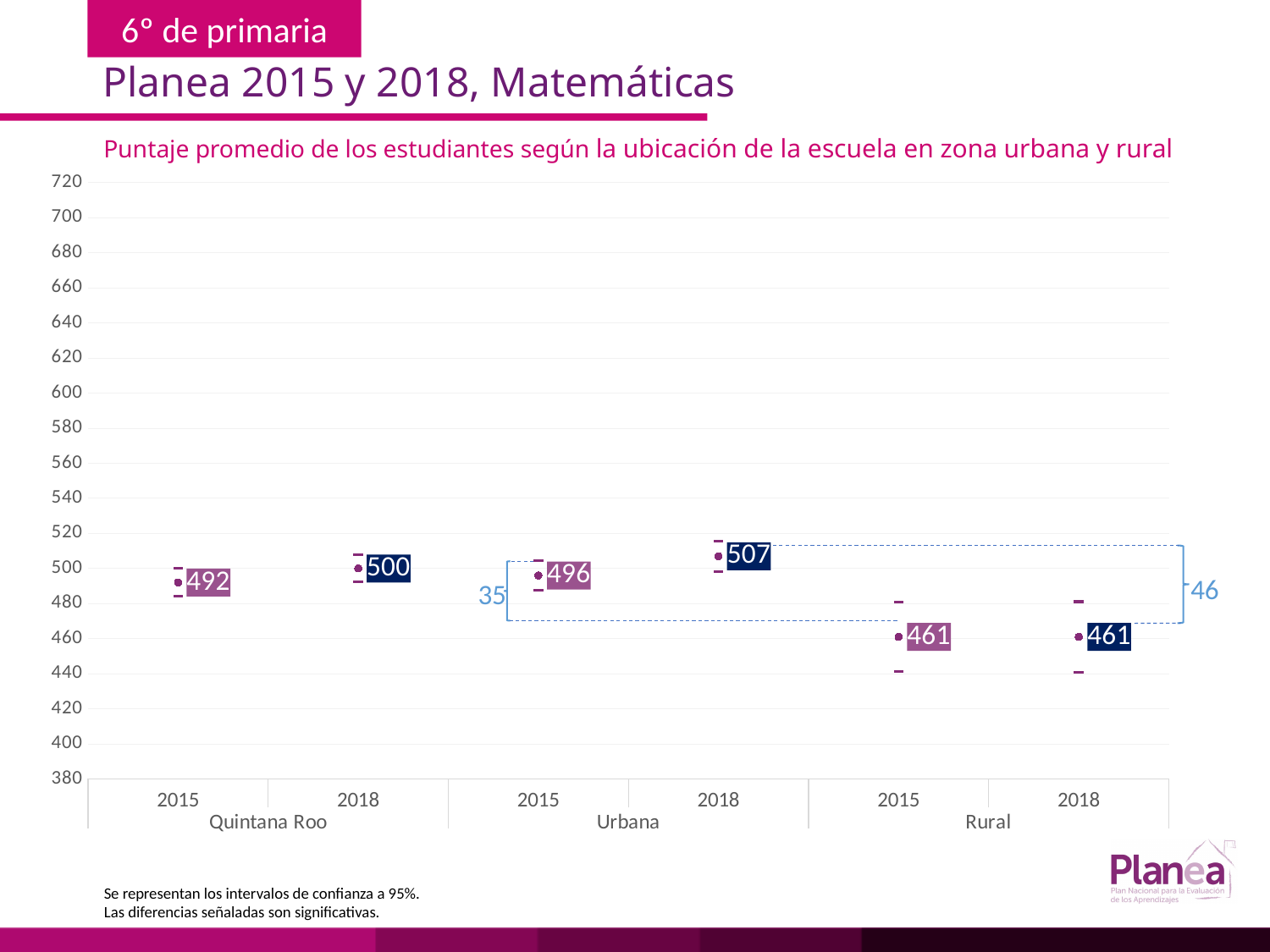
What is the average score for Quintana Roo in 2018? 500 What is the difference between the Urbana and Rural scores in 2018? 46 Which group and year has the highest average score? Urbana 2018 By how many points did the Quintana Roo score change from 2015 to 2018? 8 What is the difference between the Urbana and Rural scores in 2015? 35 What is the average score for Rural schools in 2015? 461 Which is larger, the Urbana 2015 score or the Rural 2015 score? Urbana 2015 How many data points are plotted on the chart? 6 What is the title of the chart? Puntaje promedio de los estudiantes según la ubicación de la escuela en zona urbana y rural What is the average score for Urbana schools in 2018? 507 What is the average score for Quintana Roo in 2015? 492 Did the Rural score rise, fall or stay the same from 2015 to 2018? Stayed the same